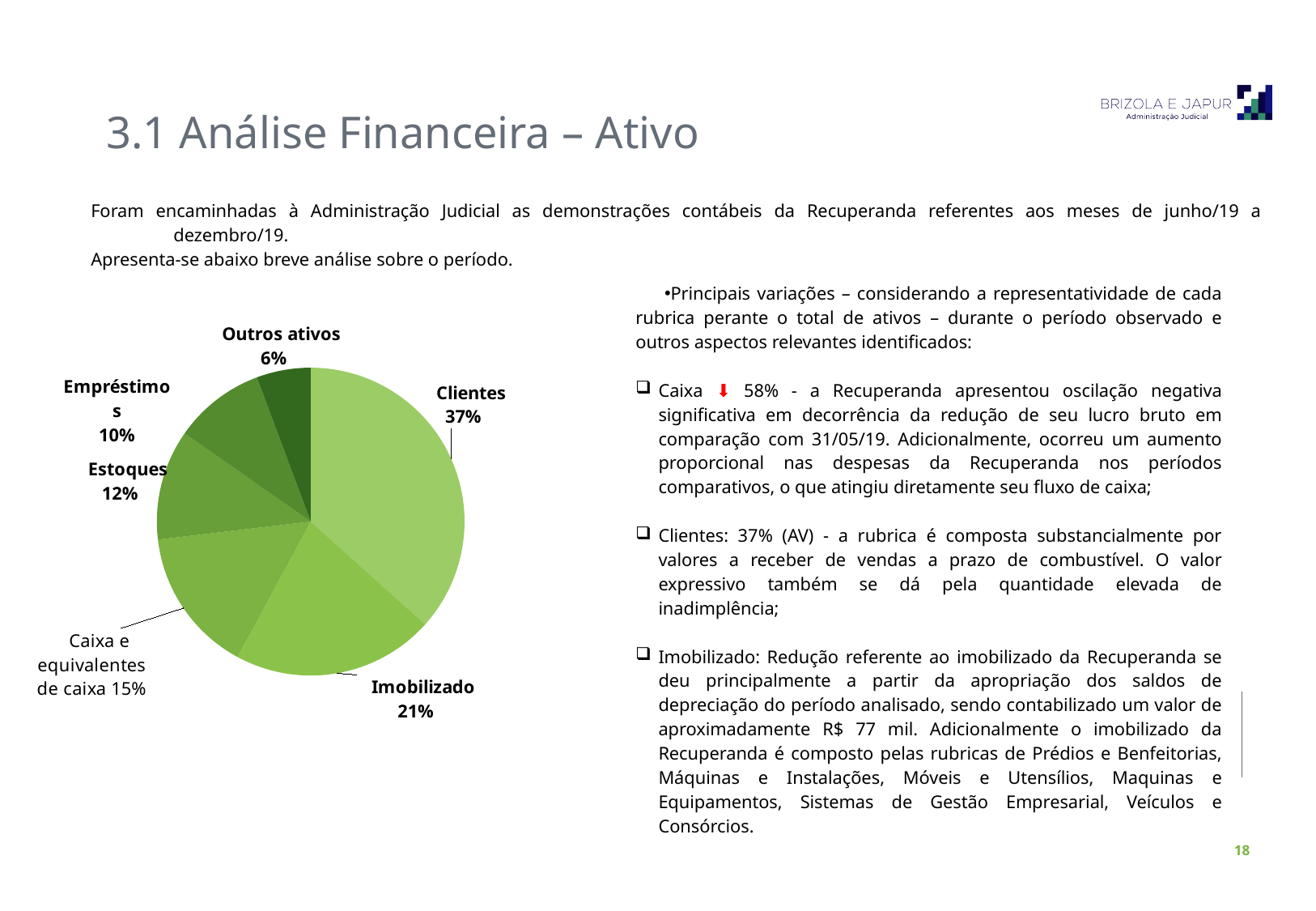
What kind of chart is shown on the slide? Pie chart What share of the pie does Clientes represent? 37% Which category has the largest slice of the pie? Clientes What is the value shown for Estoques? 12% What is the value shown for Empréstimos? 10% What is the value shown for Caixa e equivalentes de caixa? 15% Which category has the smallest slice of the pie? Outros ativos What is the difference in percentage points between Clientes and Imobilizado? 16 What share of the pie does Imobilizado represent? 21% What is the value shown for Outros ativos? 6% Which is larger, Estoques or Empréstimos? Estoques How many slices does the pie chart have? 6